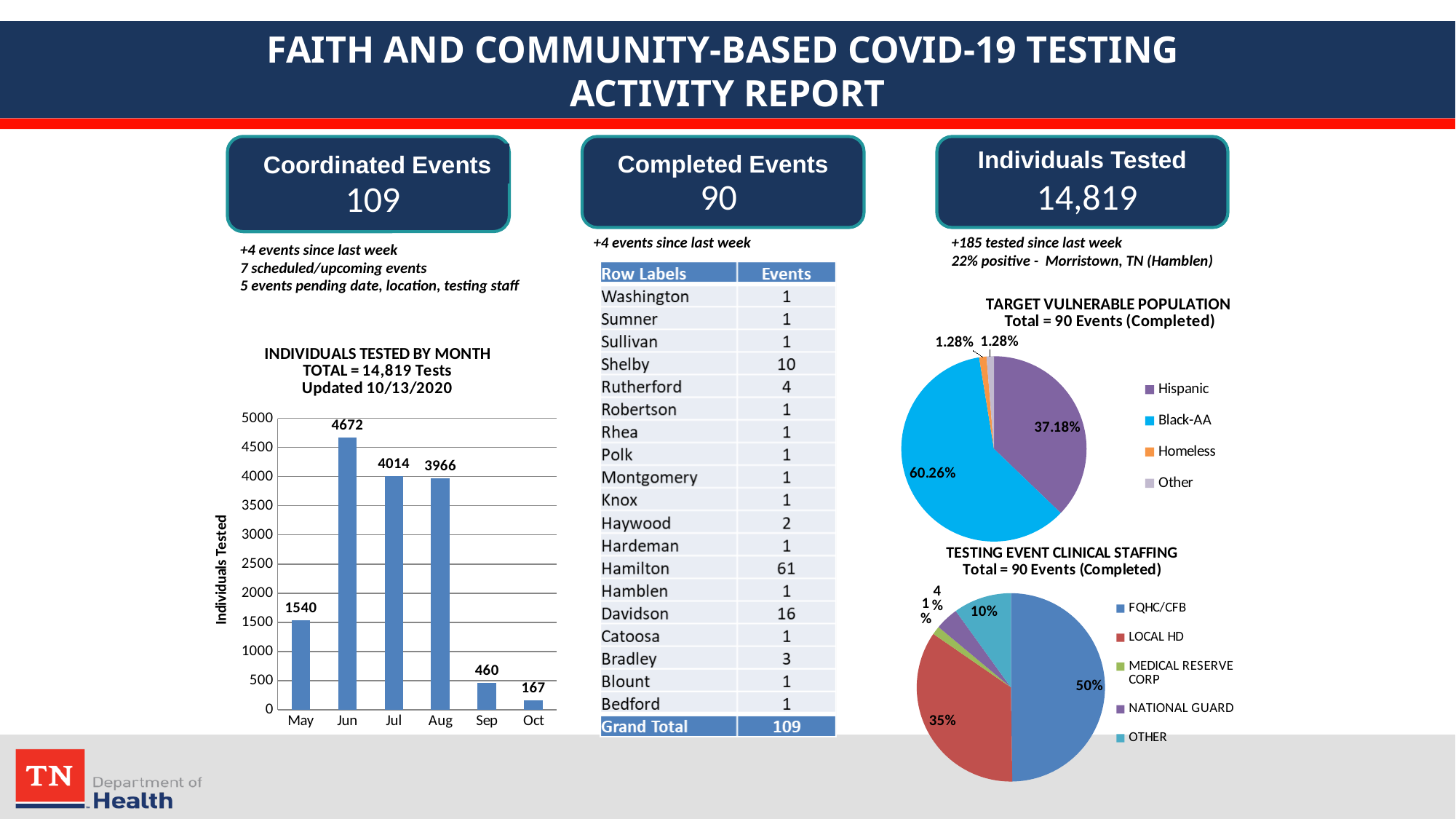
In the 'Target Vulnerable Population' pie chart, what share is Black-AA? 60.26% In the 'Individuals Tested by Month' chart, what is the difference between the number tested in July and in August? 48 In the 'Individuals Tested by Month' chart, how many individuals were tested in October? 167 In the 'Individuals Tested by Month' chart, how many individuals were tested in June? 4672 How many months are shown in the 'Individuals Tested by Month' chart? 6 In the 'Individuals Tested by Month' chart, which month has the lowest number of individuals tested? Oct In the 'Individuals Tested by Month' chart, which month had more individuals tested, May or September? May What type of chart is the 'Individuals Tested by Month' chart? Bar chart In the 'Target Vulnerable Population' pie chart, what share is Hispanic? 37.18% How many categories does the legend of the 'Testing Event Clinical Staffing' pie chart list? 5 In the 'Individuals Tested by Month' chart, which month has the highest number of individuals tested? Jun In the 'Testing Event Clinical Staffing' pie chart, what share is Local HD? 35%